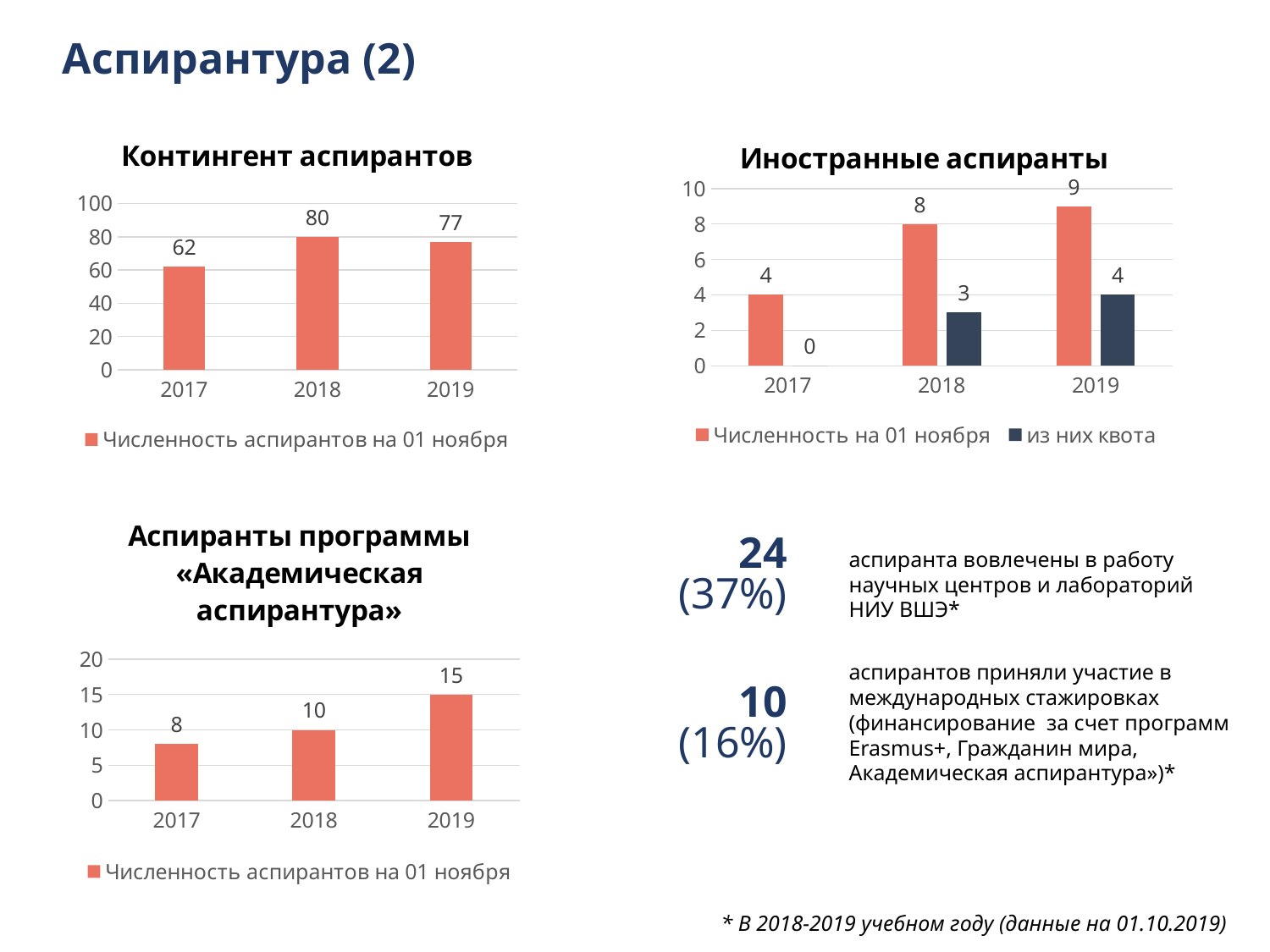
What type of chart is 'Иностранные аспиранты'? bar chart In the chart 'Иностранные аспиранты', what is the value of 'Численность на 01 ноября' for 2019? 9 In the chart 'Аспиранты программы «Академическая аспирантура»', what is the value for 2019? 15 How many years are shown on the x axis of the chart 'Контингент аспирантов'? 3 In the chart 'Иностранные аспиранты', how many series does the legend list? 2 In the chart 'Иностранные аспиранты', which year has the highest value of 'Численность на 01 ноября'? 2019 In the chart 'Контингент аспирантов', which year has the lowest value? 2017 In the chart 'Контингент аспирантов', what is the value for 2018? 80 In the chart 'Аспиранты программы «Академическая аспирантура»', what is the difference between the values for 2019 and 2017? 7 In the chart 'Иностранные аспиранты', what is the value of 'из них квота' for 2018? 3 In the chart 'Аспиранты программы «Академическая аспирантура»', do the values rise or fall from 2017 to 2019? rise In the chart 'Контингент аспирантов', what is the difference between the values for 2018 and 2017? 18